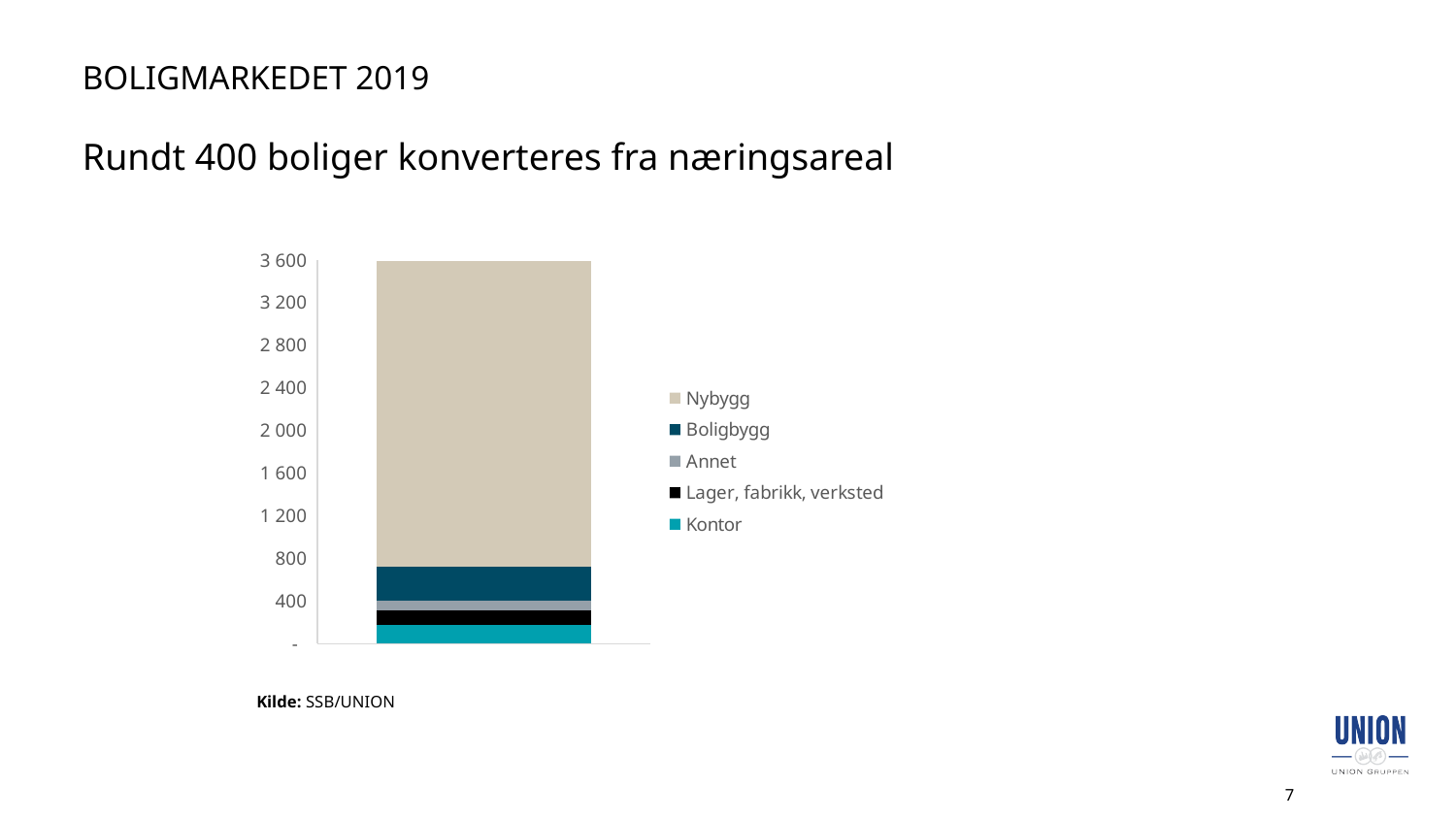
Is the cumulative top of the Boligbygg segment greater or less than 400? greater Which series makes up the smallest segment of the stacked bar? Annet Which segment is larger, Boligbygg or Kontor? Boligbygg What source is cited below the chart? SSB/UNION Is the Kontor segment greater or less than 400? less Which series makes up the largest segment of the stacked bar? Nybygg Which legend entry is listed last? Kontor How many bars are plotted in the chart? 1 Which segment is larger, Nybygg or Boligbygg? Nybygg How many series does the legend list? 5 What kind of chart is shown on the slide? Stacked bar chart Is the total height of the stacked bar greater or less than 3 200? greater